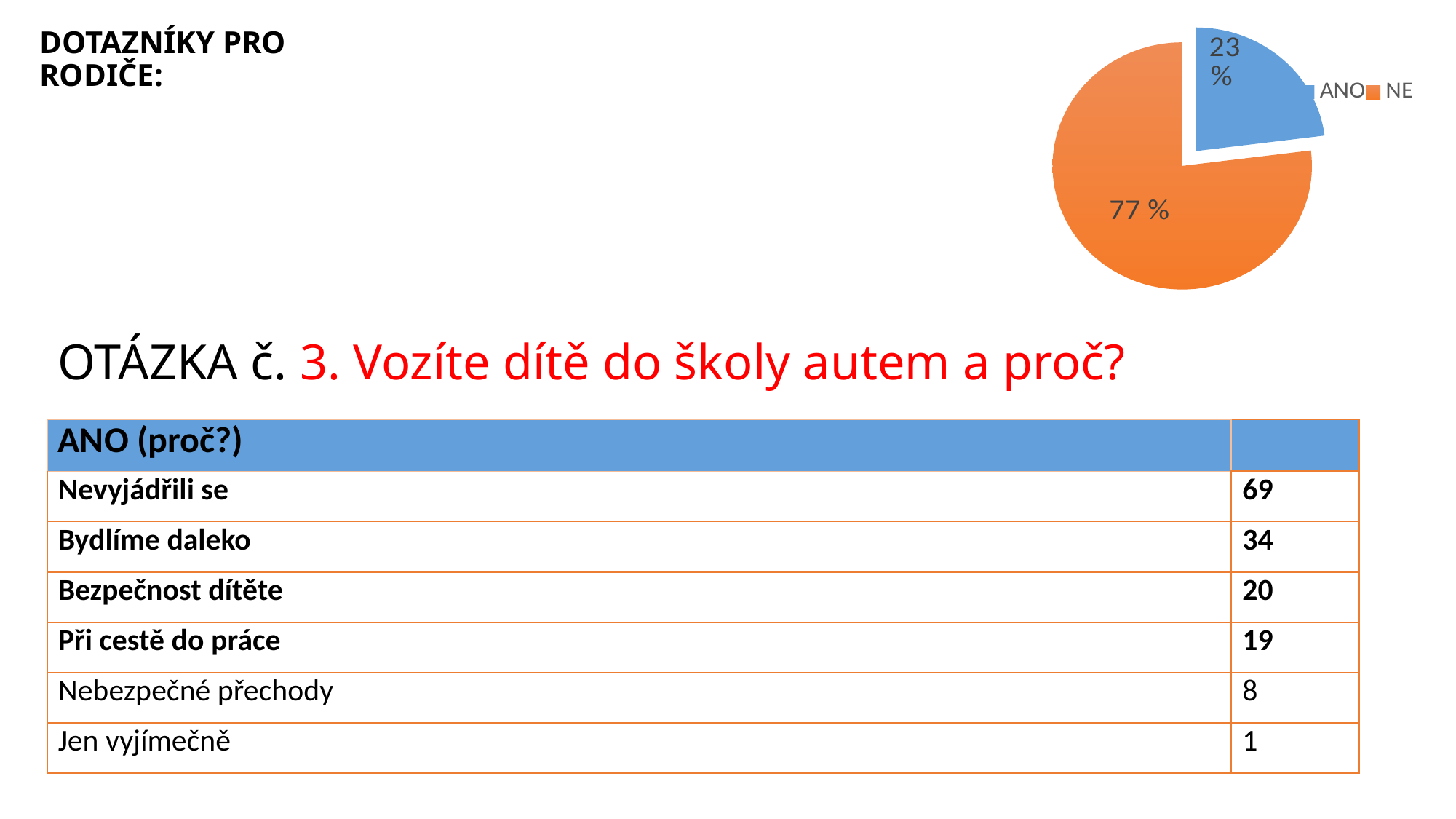
What share of the pie chart is labelled ANO? 23 % What colour is the ANO slice of the pie chart? blue How many entries does the pie chart legend list? 2 Which slice of the pie chart is the largest? NE Which slice of the pie chart is the smallest? ANO What kind of chart is shown on the slide? pie chart What colour is the NE slice of the pie chart? orange What share of the pie chart is labelled NE? 77 % What is the difference in percentage points between the NE and ANO slices of the pie chart? 54 How many slices does the pie chart have? 2 Which is larger in the pie chart, ANO or NE? NE